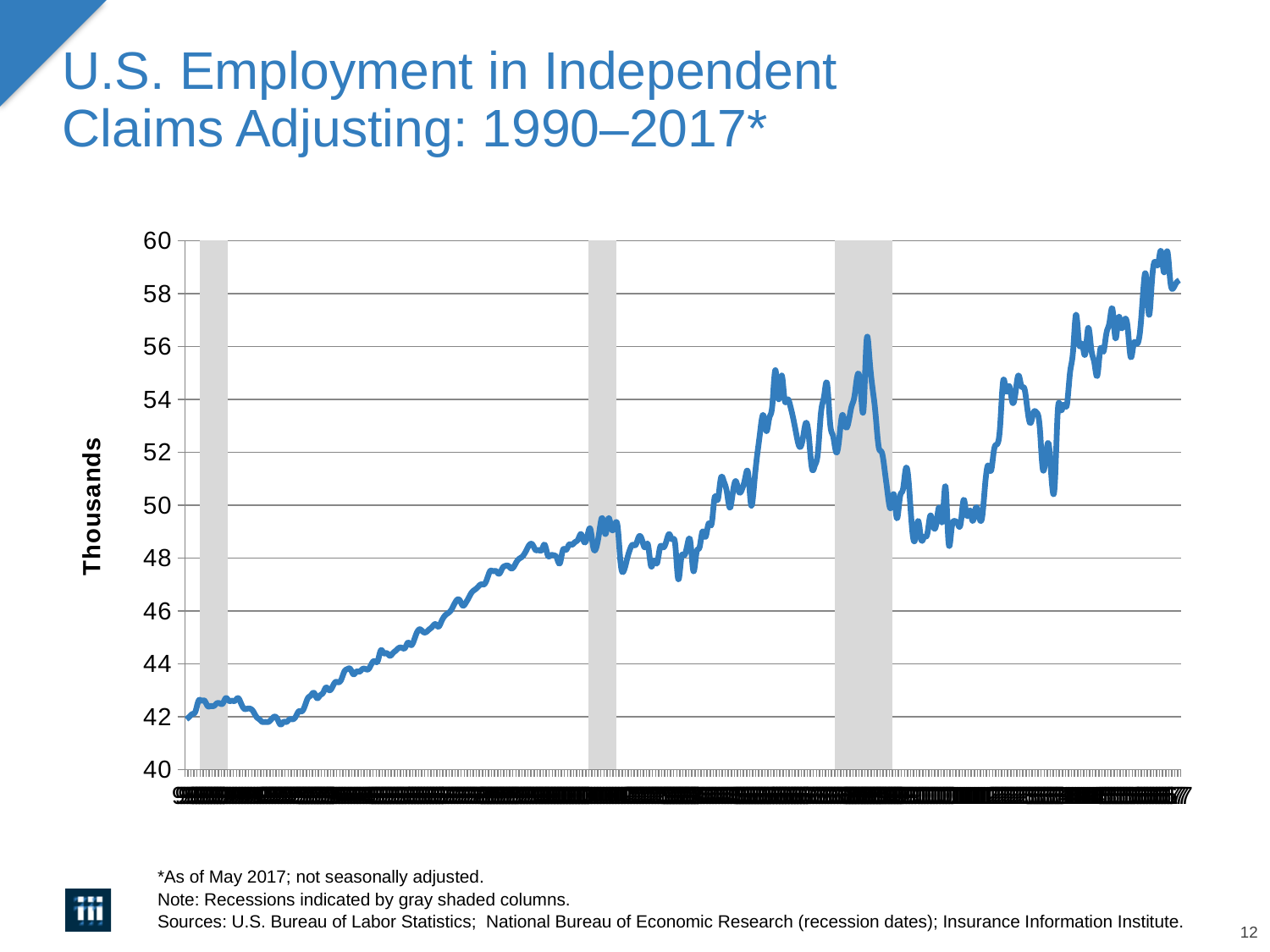
How many gray shaded recession columns appear on the chart? 3 Is the value at the start of the line (left end) greater or less than 44? less Is the highest point reached by the line greater or less than 58? greater What is the label on the vertical axis of the chart? Thousands Is the value at the end of the line (right end) larger or smaller than the value at the start of the line (left end)? larger Is the lowest point reached by the line greater or less than 44? less What kind of chart is shown on the slide? line chart Overall, do the values on the line rise or fall from the left of the x axis to the right? rise